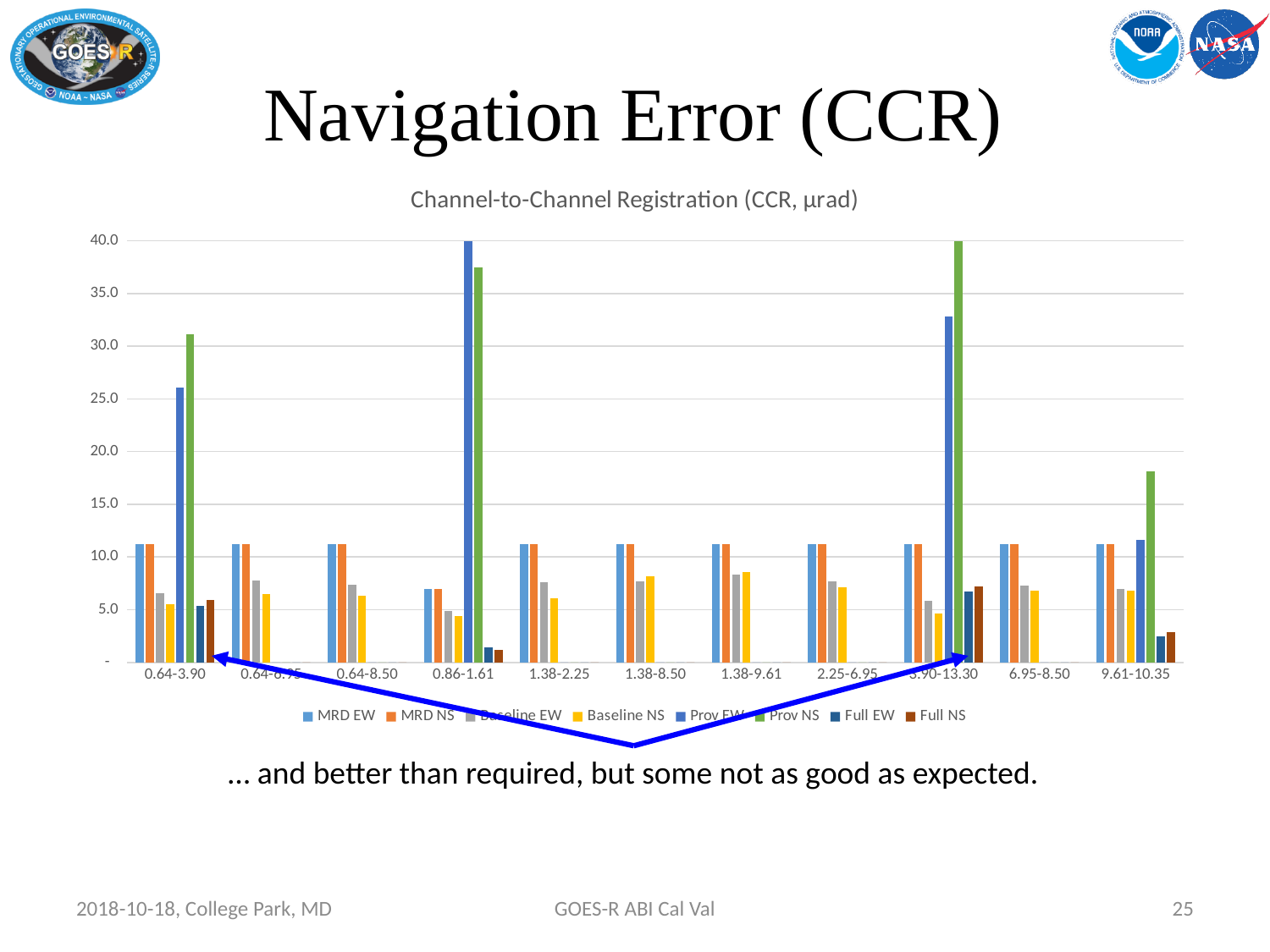
For 0.64-3.90, which is larger: Baseline EW or Prov EW? Prov EW Which category has the highest Prov EW value? 0.86-1.61 Is the Prov NS value for 0.64-3.90 greater or less than 30.0? greater For 9.61-10.35, which is larger: Prov EW or Prov NS? Prov NS Is the Prov NS value for 9.61-10.35 greater or less than 15.0? greater Is the Prov EW value for 3.90-13.30 greater or less than 30.0? greater What kind of chart is shown on the slide? bar chart What is the title of the chart? Channel-to-Channel Registration (CCR, μrad) How many channel-pair categories are shown on the x axis? 11 How many series does the chart legend list? 8 Which category has the highest Prov NS value? 3.90-13.30